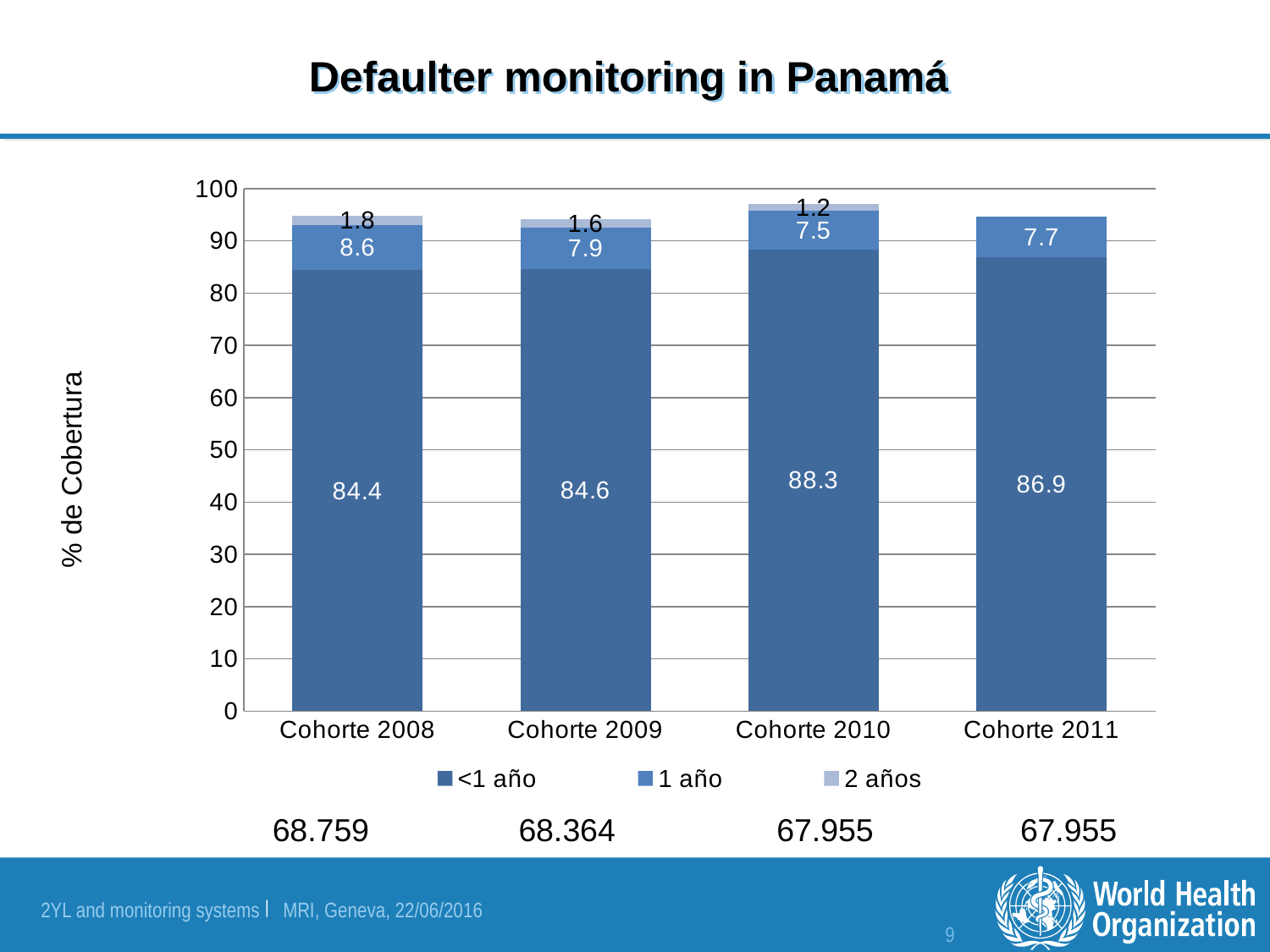
How many series does the legend list? 3 Which cohort has the lowest "2 años" value among those labelled? Cohorte 2010 What is the value of the "2 años" series for Cohorte 2009? 1.6 What kind of chart is shown on the slide? Stacked bar chart Which is larger, the "1 año" value for Cohorte 2009 or for Cohorte 2011? Cohorte 2009 Which cohort has the highest "<1 año" value? Cohorte 2010 What is the label of the y axis? % de Cobertura What is the value of the "<1 año" series for Cohorte 2010? 88.3 What is the total of the stacked bar for Cohorte 2008? 94.8 What is the value of the "1 año" series for Cohorte 2008? 8.6 How many cohorts are shown on the x axis? 4 What is the difference between the "<1 año" values for Cohorte 2010 and Cohorte 2008? 3.9